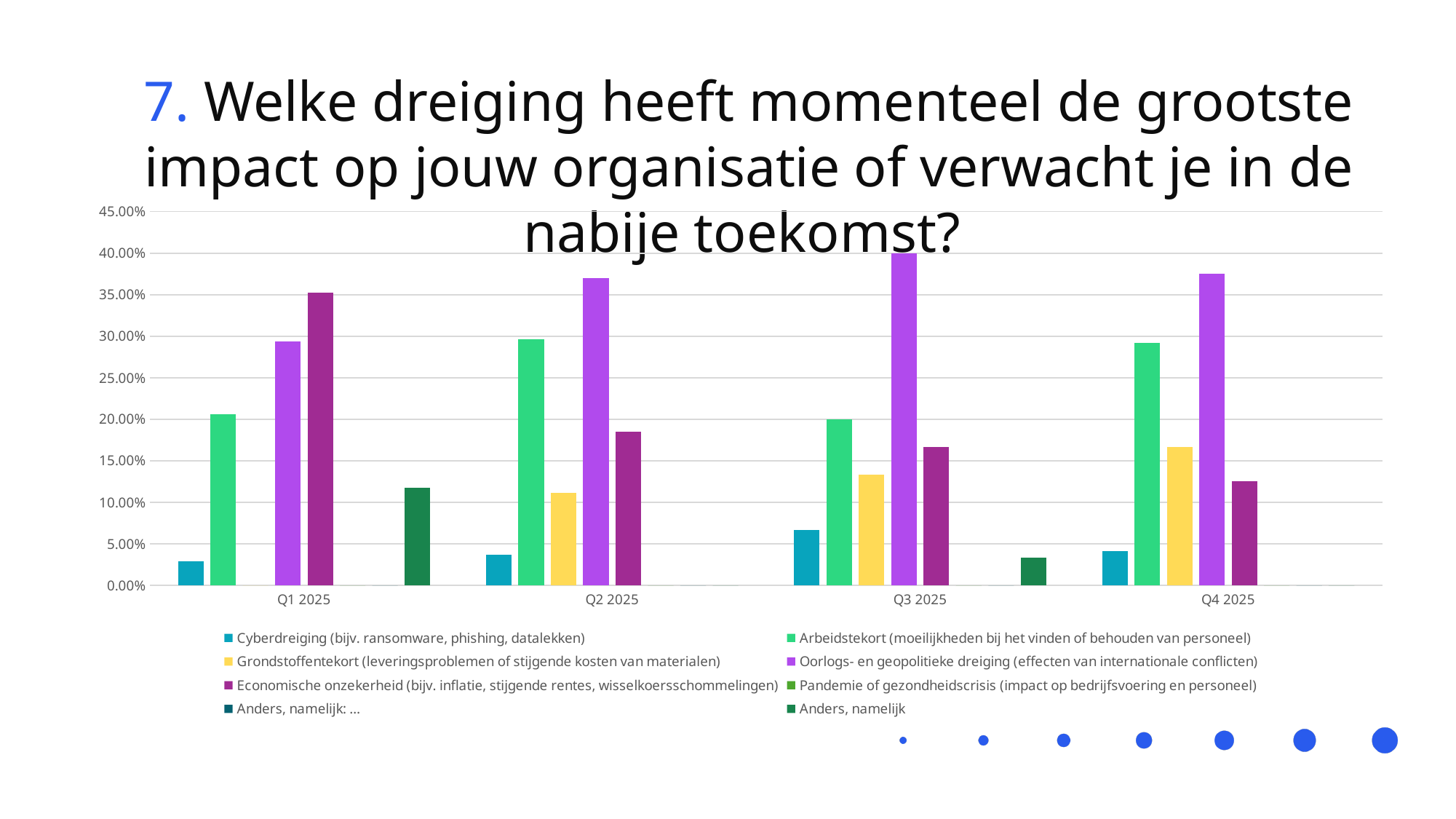
Is the value for Economische onzekerheid in Q1 2025 greater or less than 30%? greater How many quarters (categories) are shown on the x axis? 4 Which series has the highest value in Q3 2025? Oorlogs- en geopolitieke dreiging What colour are the bars for Oorlogs- en geopolitieke dreiging? purple Is the value for Oorlogs- en geopolitieke dreiging in Q3 2025 greater or less than 35%? greater Is the value for Economische onzekerheid in Q4 2025 greater or less than 15%? less How many series does the legend list? 8 Which series has the highest value in Q1 2025? Economische onzekerheid In Q2 2025, which is larger: Arbeidstekort or Economische onzekerheid? Arbeidstekort Does the value for Economische onzekerheid rise or fall from Q1 2025 to Q4 2025? fall What kind of chart is shown on the slide? bar chart